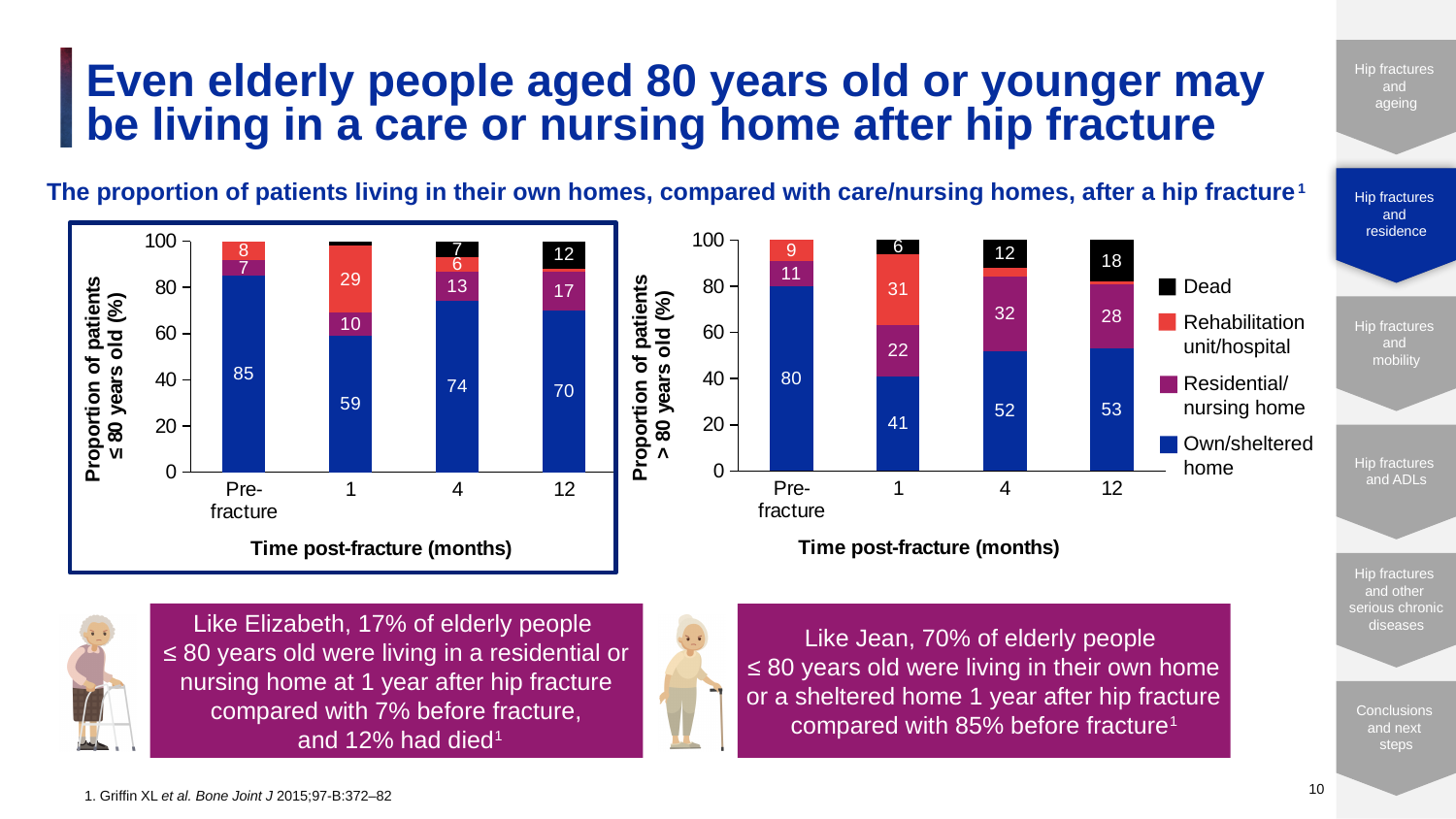
What kind of chart is the right chart (>80 years old)? Stacked bar chart In the right chart (>80 years old), at which time point is the Residential/nursing home value highest? 4 In the right chart (>80 years old), is the Own/sheltered home value at 1 month greater or less than 60? less In the right chart (>80 years old), which is larger: the Own/sheltered home value at 4 months or at 12 months? 12 months In the left chart (≤80 years old), what is the value for Residential/nursing home at 12 months post-fracture? 17 In the right chart (>80 years old), what is the value for Rehabilitation unit/hospital at 1 month post-fracture? 31 In the left chart (≤80 years old), what is the difference between the Own/sheltered home value at pre-fracture and at 12 months? 15 In the right chart (>80 years old), what is the value for Dead at 12 months post-fracture? 18 How many series does the legend list? 4 In the left chart (≤80 years old), what is the value for Own/sheltered home at pre-fracture? 85 In the left chart (≤80 years old), at which time point is the Own/sheltered home value lowest? 1 How many time points are shown on the x axis of the left chart (≤80 years old)? 4